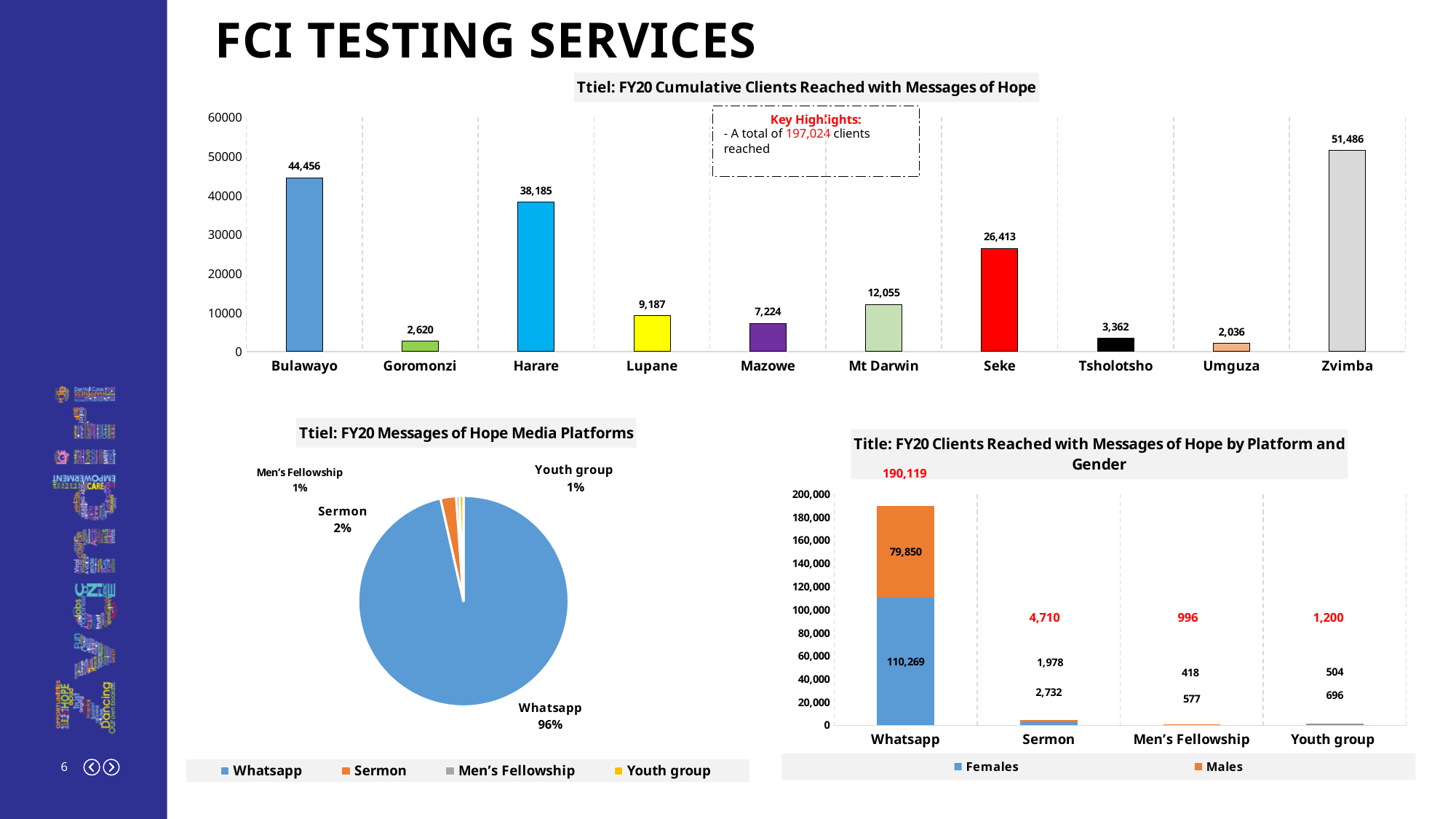
In the top chart 'FY20 Cumulative Clients Reached with Messages of Hope', is the value for Mt Darwin greater or less than 10000? greater In the top chart 'FY20 Cumulative Clients Reached with Messages of Hope', what is the difference between Bulawayo and Seke? 18,043 In the top chart 'FY20 Cumulative Clients Reached with Messages of Hope', what is the value for Harare? 38,185 In the top chart 'FY20 Cumulative Clients Reached with Messages of Hope', which district has the lowest value? Umguza In the pie chart 'FY20 Messages of Hope Media Platforms', what share does Sermon have? 2% In the chart 'FY20 Clients Reached with Messages of Hope by Platform and Gender', what is the Females value for Whatsapp? 110,269 In the pie chart 'FY20 Messages of Hope Media Platforms', what share does Whatsapp have? 96% What kind of chart is 'FY20 Messages of Hope Media Platforms'? pie chart In the top chart 'FY20 Cumulative Clients Reached with Messages of Hope', how many districts are shown? 10 In the top chart 'FY20 Cumulative Clients Reached with Messages of Hope', which district has the highest value? Zvimba In the chart 'FY20 Clients Reached with Messages of Hope by Platform and Gender', what is the total of the stacked bar for Sermon? 4,710 How many series does the legend list in the chart 'FY20 Clients Reached with Messages of Hope by Platform and Gender'? 2